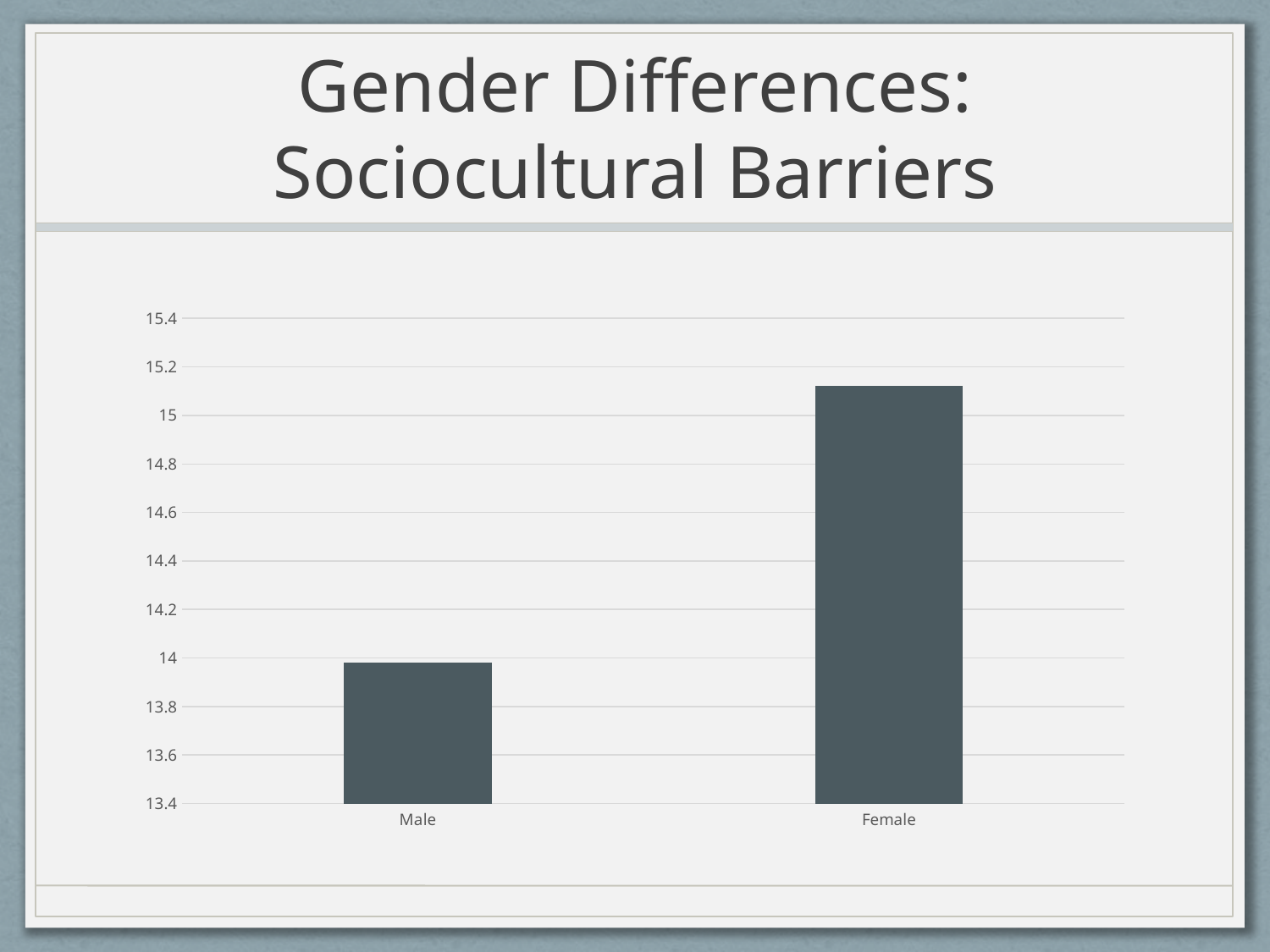
Which category has the highest value? Female Is the value for Female greater or less than 15? greater Which category has the lowest value? Male What is the title of the slide containing the chart? Gender Differences: Sociocultural Barriers Is the value for Female greater or less than 15.2? less Which is larger, the value for Male or the value for Female? Female What kind of chart is shown on the slide? bar chart How many categories are plotted on the chart? 2 Do the values rise or fall moving from Male to Female along the x axis? rise Is the value for Male greater or less than 13.8? greater What is the lowest value shown on the vertical axis? 13.4